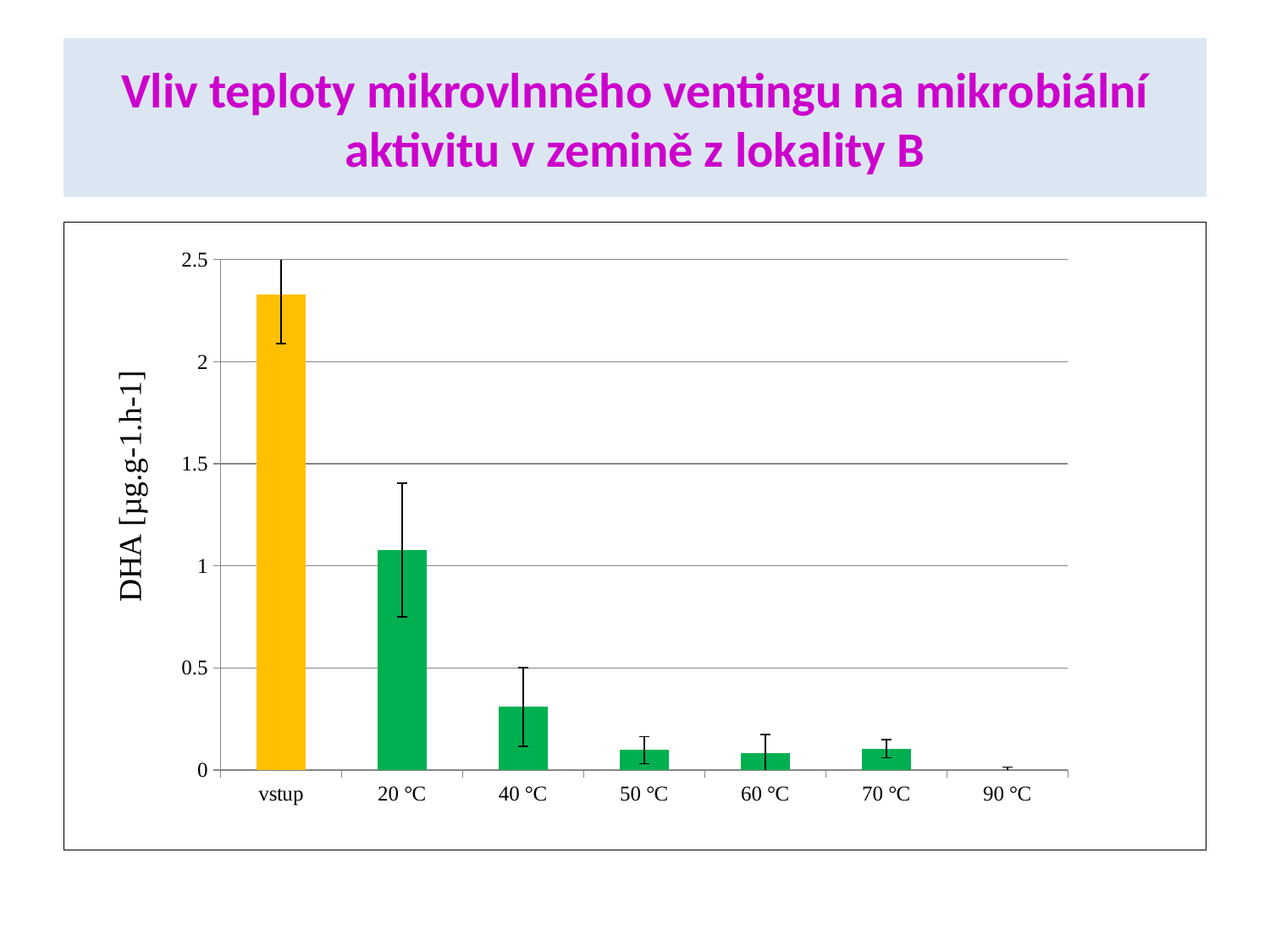
What kind of chart is shown on the slide? bar chart Is the value for 40 °C greater or less than 0.5? less Which category has the highest DHA value? vstup Is the value for 20 °C greater or less than 1? greater What is the label of the y axis? DHA [µg.g-1.h-1] Which is larger, the value for 20 °C or the value for 40 °C? 20 °C Is the value for vstup greater or less than 2? greater How many categories are shown on the x axis of the chart? 7 What colour is the bar for vstup? yellow Which category has the lowest DHA value? 90 °C Do the DHA values generally rise or fall as the temperature increases along the x axis? fall